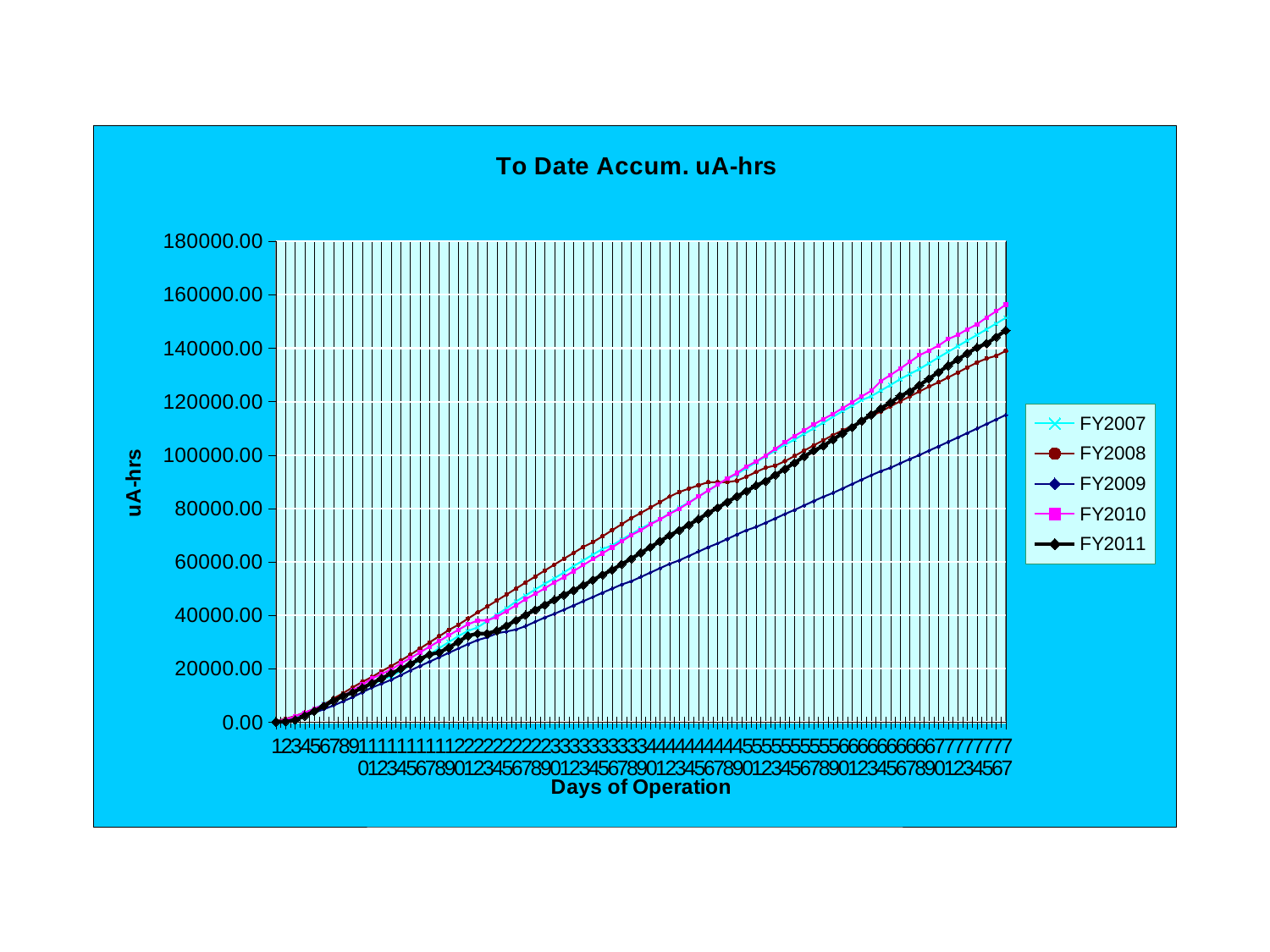
What kind of chart is shown on the slide? line chart Do the values for FY2010 rise or fall as the days of operation increase? rise At the last day of operation shown, is the value for FY2008 greater or less than 120000.00? greater At the last day of operation shown, is the value for FY2010 greater or less than 140000.00? greater Which series has the lowest value at the last day of operation shown? FY2009 At the last day of operation shown, is the value for FY2009 greater or less than 120000.00? less What is the label of the x axis? Days of Operation What is the title of the chart? To Date Accum. uA-hrs At the last day of operation shown, which is larger, the value for FY2011 or the value for FY2009? FY2011 How many series does the legend list? 5 How many days of operation does the x axis cover? 77 Which series has the highest value at the last day of operation shown? FY2010